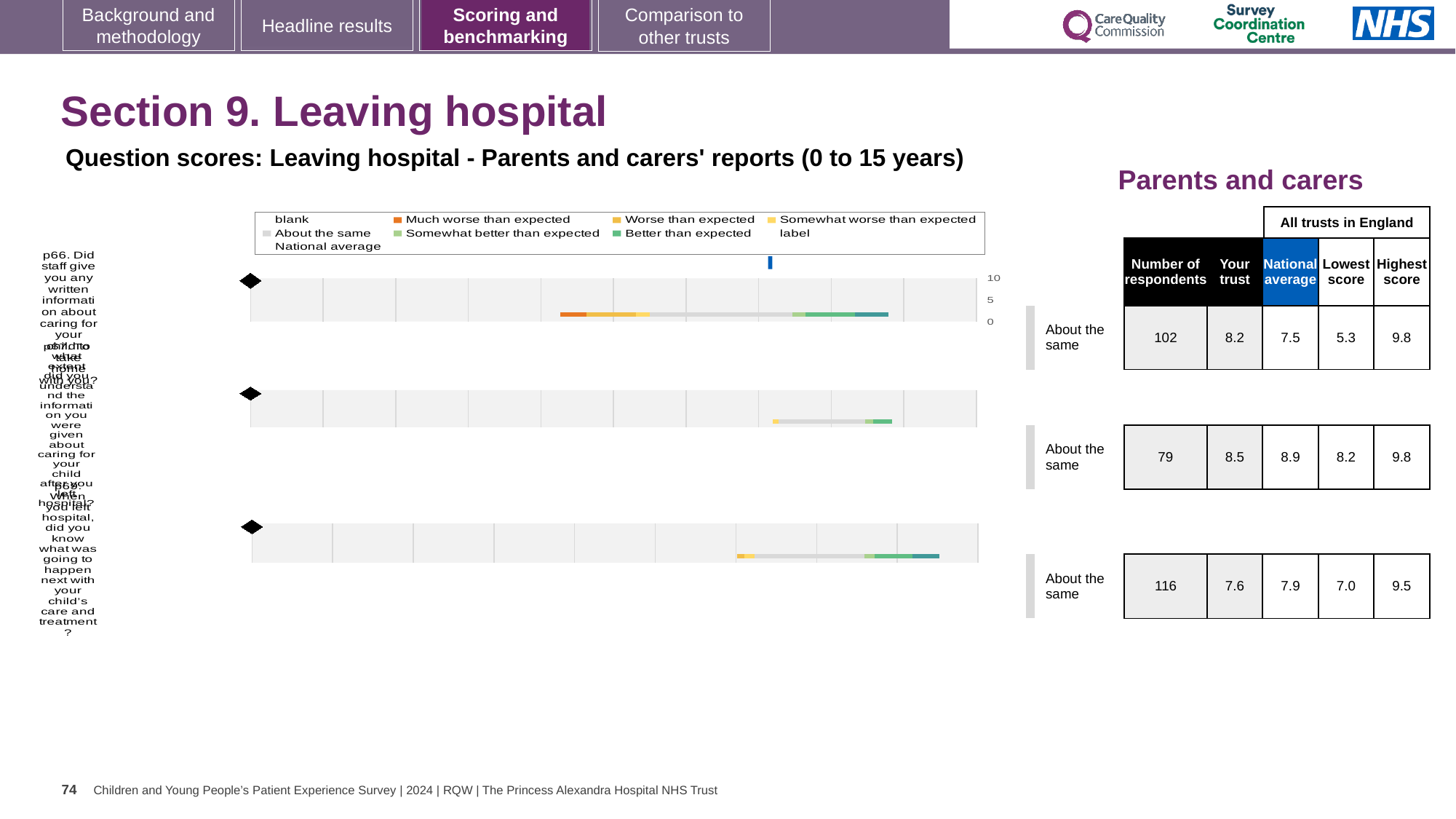
In the table beside the chart, which question row has the highest number of respondents? the third row (116) In the table beside the chart, what is the number of respondents for the third question row? 116 What benchmark category is shown for all three question rows? About the same What kind of chart is shown on the slide? bar chart In the table beside the chart, for the second question row, which is larger: the 'Your trust' score or the national average? National average In the table beside the chart, what is the lowest score for the third question row? 7.0 In the table beside the chart, what is the difference between 'Your trust' and the national average for the first question row? 0.7 In the table beside the chart, what is the national average for the second question row? 8.9 How many question rows (bars) are plotted in the chart? 3 In the table beside the chart, what is the 'Your trust' score for the first question row? 8.2 What is the highest tick value shown on the chart's axis? 10 Which colour does the legend use for 'Much worse than expected'? orange